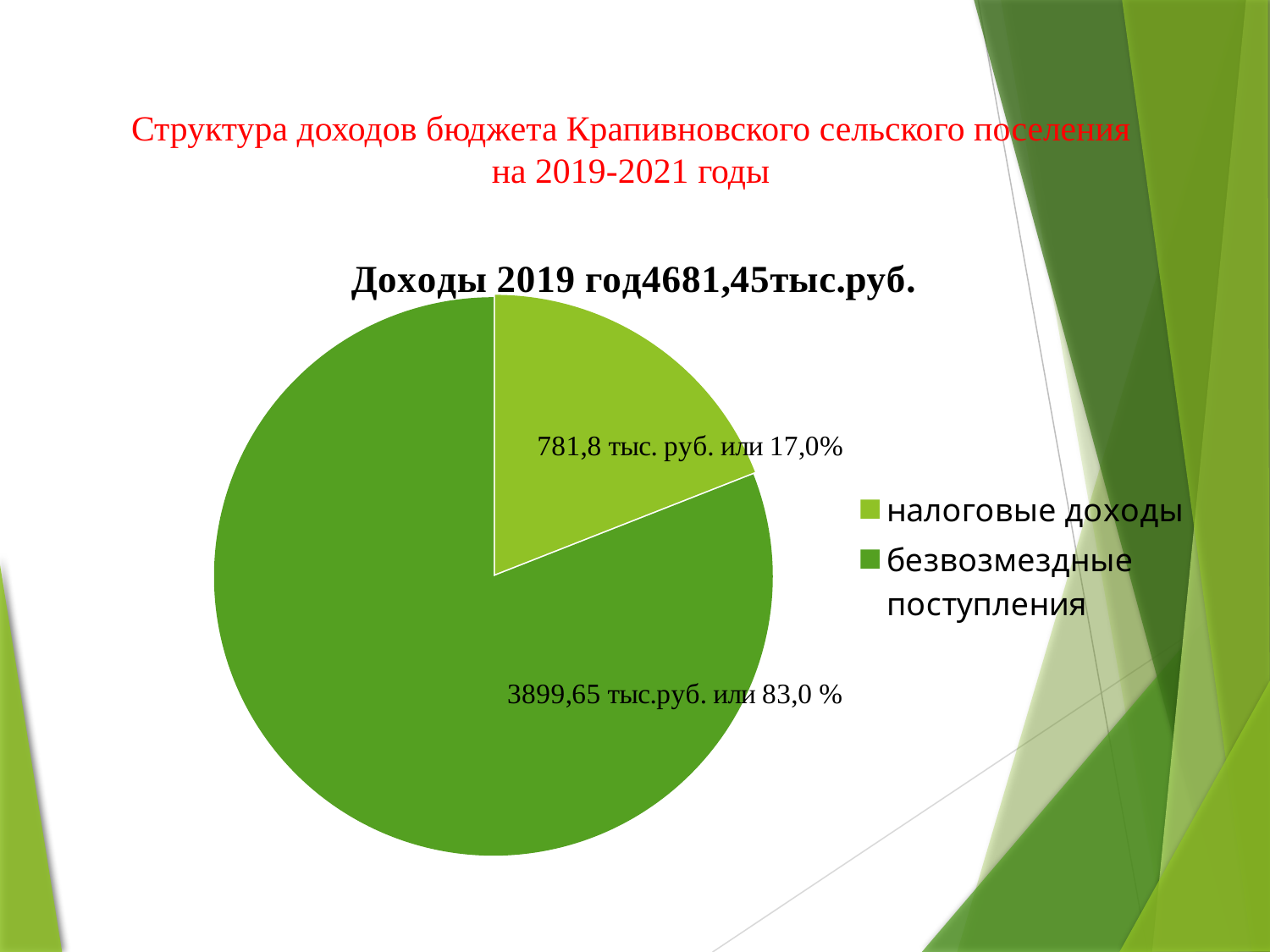
Which category has the largest slice of the pie? безвозмездные поступления What is the value shown for налоговые доходы? 781,8 тыс. руб. What is the value shown for безвозмездные поступления? 3899,65 тыс.руб. What is the difference in percentage points between безвозмездные поступления and налоговые доходы? 66,0 % Which category has the smallest slice of the pie? налоговые доходы What is the title of the chart? Доходы 2019 год4681,45тыс.руб. What share of the pie does безвозмездные поступления represent? 83,0 % What kind of chart is shown on the slide? pie chart What share of the pie does налоговые доходы represent? 17,0% Which legend entry is shown in the lighter green colour? налоговые доходы How many categories does the pie chart have? 2 Which is larger, налоговые доходы or безвозмездные поступления? безвозмездные поступления